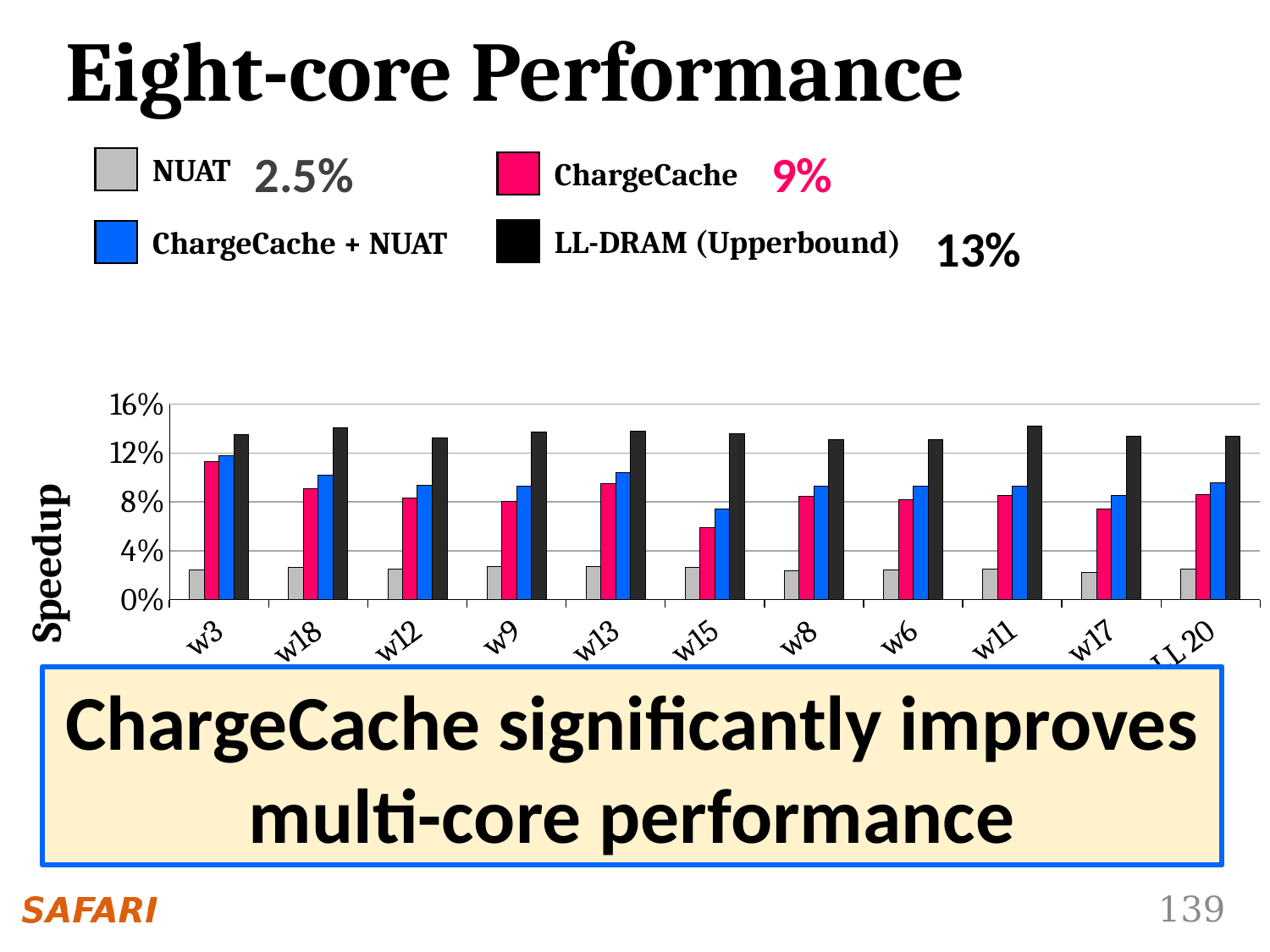
What is the label on the vertical axis of the chart? Speedup Is the NUAT speedup for w3 greater or less than 4%? less For w12, which is larger: the LL-DRAM (Upperbound) speedup or the ChargeCache speedup? LL-DRAM (Upperbound) How many series does the legend list? 4 Is the ChargeCache speedup for w15 greater or less than 8%? less Is the ChargeCache speedup for w3 greater or less than 8%? greater What colour represents LL-DRAM (Upperbound) in the chart? black Which workload has the lowest ChargeCache speedup? w15 What kind of chart is shown on the slide? bar chart Which workload has the highest ChargeCache speedup? w3